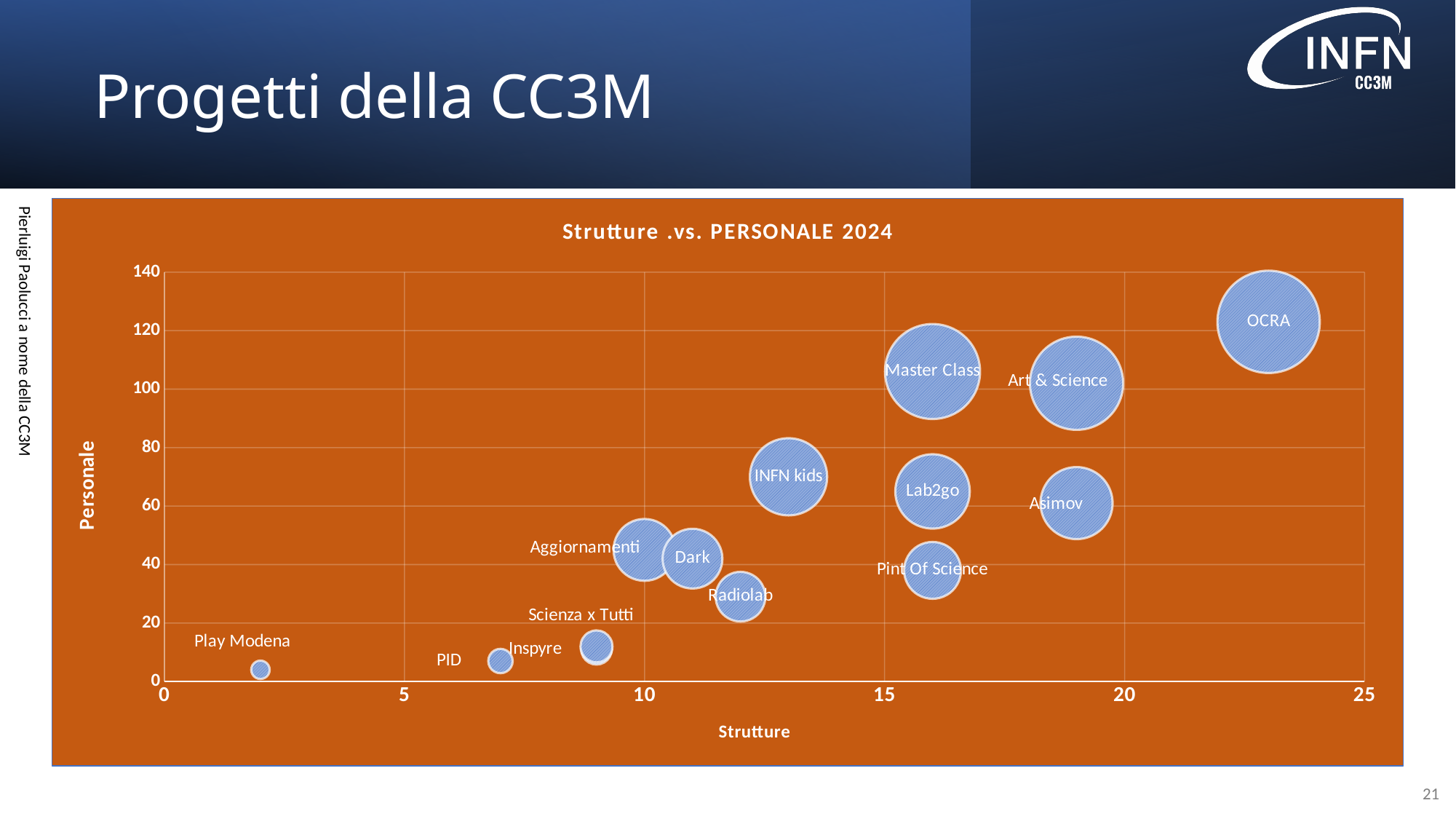
Which project has the highest Strutture value? OCRA Which project has the lowest Strutture value? Play Modena Which has a higher Personale value, Master Class or Lab2go? Master Class Which project has the highest Personale value? OCRA Is the Personale value for INFN kids greater or less than 80? less What is the title of the chart? Strutture .vs. PERSONALE 2024 What kind of chart is shown on the slide? bubble chart Is the Personale value for Radiolab greater or less than 40? less Is the Strutture value for OCRA greater or less than 20? greater Which has a higher Personale value, Art & Science or Asimov? Art & Science Which project has the lowest Personale value? Play Modena